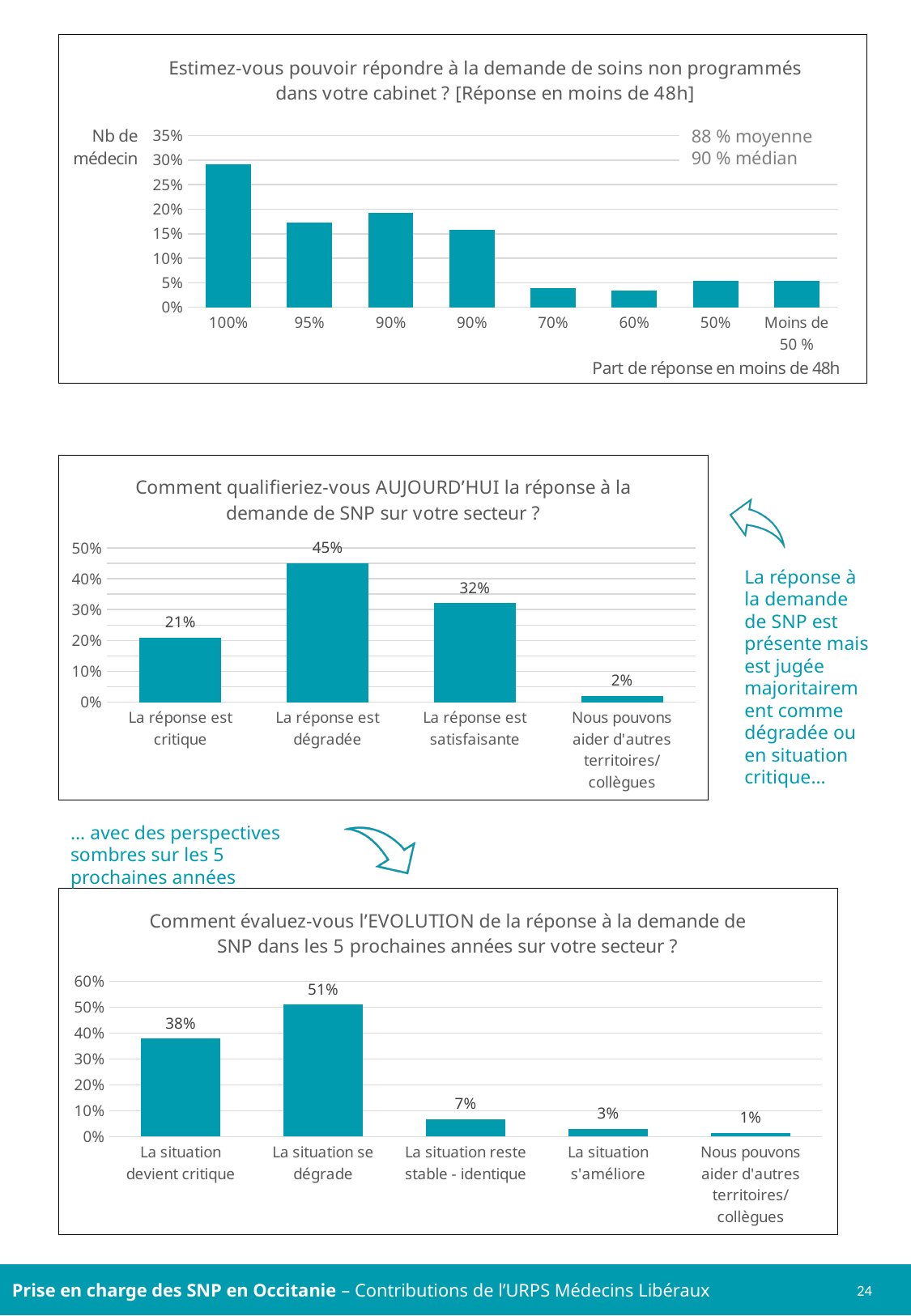
In the middle chart (Comment qualifieriez-vous AUJOURD'HUI...), what is the difference between 'La réponse est dégradée' and 'La réponse est satisfaisante'? 13% In the top chart (Estimez-vous pouvoir répondre à la demande de soins non programmés...), which category has the highest value? 100% In the bottom chart (Comment évaluez-vous l'EVOLUTION...), what is the value for 'La situation s'améliore'? 3% In the bottom chart (Comment évaluez-vous l'EVOLUTION...), how many categories are shown? 5 In the middle chart (Comment qualifieriez-vous AUJOURD'HUI...), which category has the lowest value? Nous pouvons aider d'autres territoires/collègues In the middle chart (Comment qualifieriez-vous AUJOURD'HUI la réponse à la demande de SNP sur votre secteur ?), what is the value for 'La réponse est dégradée'? 45% In the bottom chart (Comment évaluez-vous l'EVOLUTION...), what is the value for 'La situation se dégrade'? 51% In the bottom chart (Comment évaluez-vous l'EVOLUTION...), what is the difference between 'La situation se dégrade' and 'La situation devient critique'? 13% In the top chart (Estimez-vous pouvoir répondre...), is the value for the '100%' category greater or less than 25%? greater In the top chart (Estimez-vous pouvoir répondre...), how many categories are shown on the x axis? 8 In the bottom chart (Comment évaluez-vous l'EVOLUTION...), which category has the highest value? La situation se dégrade In the middle chart (Comment qualifieriez-vous AUJOURD'HUI...), what is the value for 'La réponse est critique'? 21%